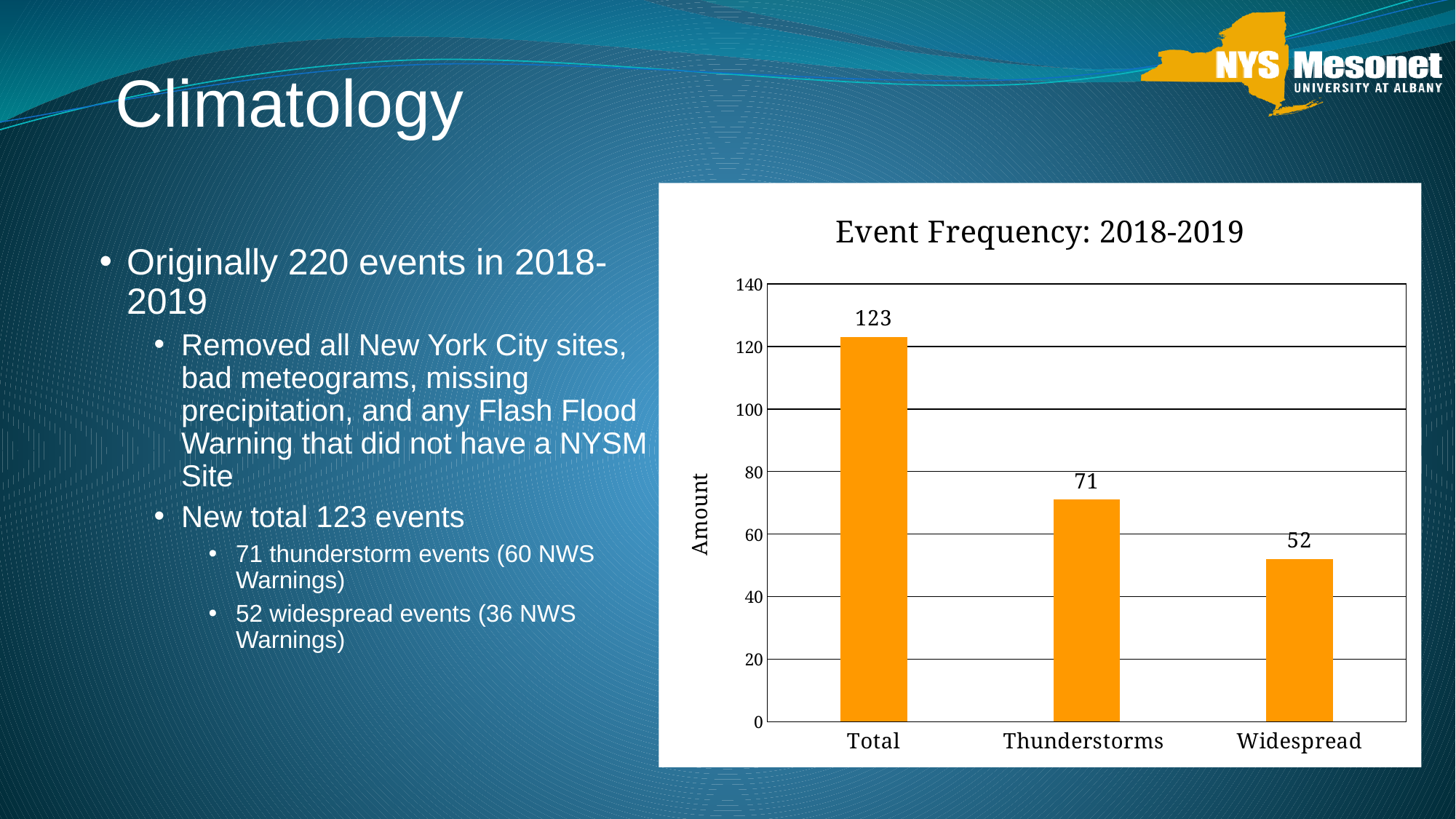
What is the label of the y axis in the Event Frequency: 2018-2019 chart? Amount What is the difference between the Thunderstorms and Widespread values in the Event Frequency: 2018-2019 chart? 19 Is the value for Thunderstorms greater or less than 80 in the Event Frequency: 2018-2019 chart? less Do the values rise or fall from left to right across the Event Frequency: 2018-2019 chart? fall Which category has the highest value in the Event Frequency: 2018-2019 chart? Total What is the value for Total in the Event Frequency: 2018-2019 chart? 123 What kind of chart is the Event Frequency: 2018-2019 chart? bar chart Which category has the lowest value in the Event Frequency: 2018-2019 chart? Widespread Which is larger in the Event Frequency: 2018-2019 chart, Thunderstorms or Widespread? Thunderstorms What is the value for Widespread in the Event Frequency: 2018-2019 chart? 52 How many categories are shown on the x axis of the Event Frequency: 2018-2019 chart? 3 What is the value for Thunderstorms in the Event Frequency: 2018-2019 chart? 71